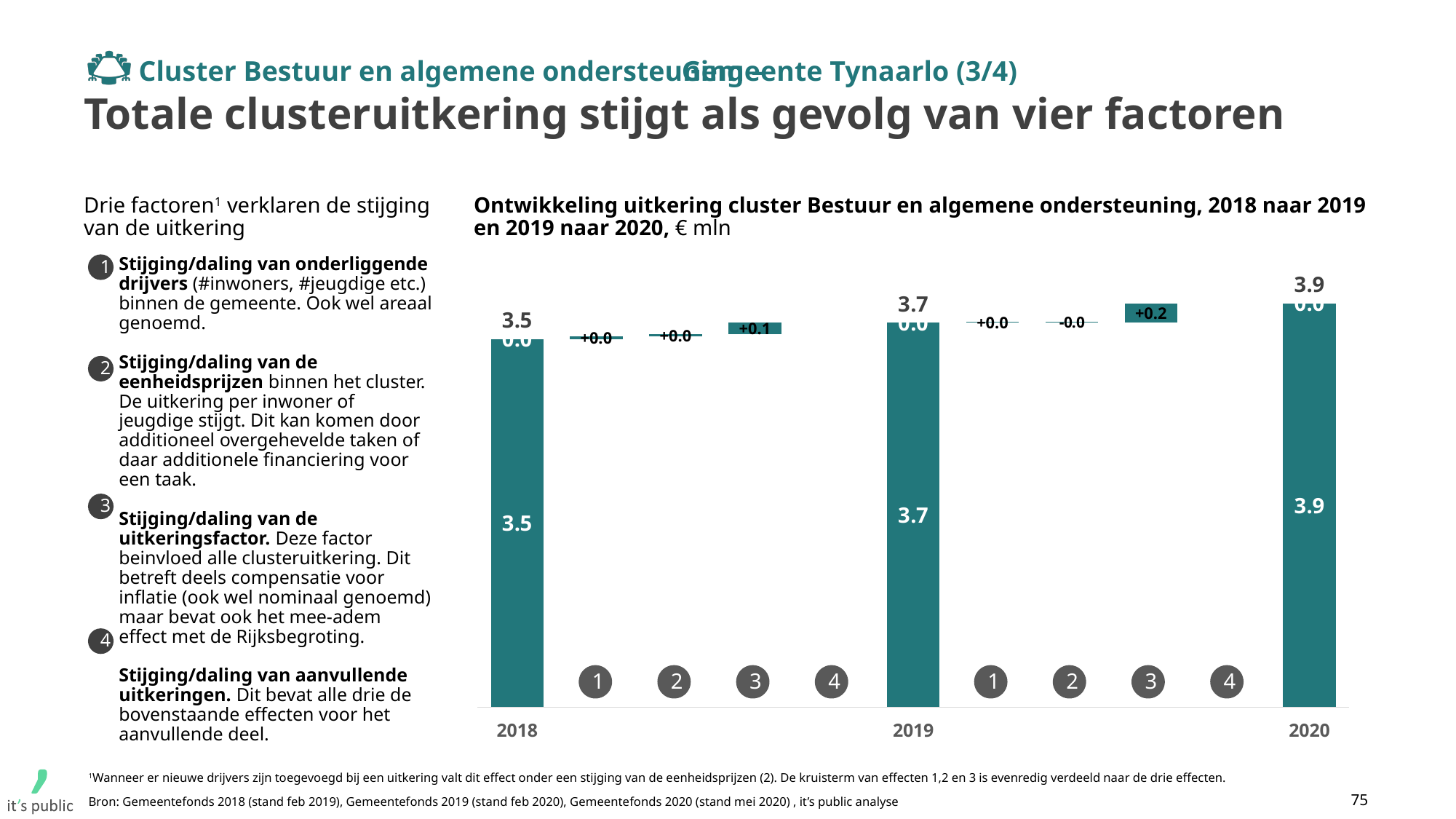
What is the effect of factor 1 from 2018 to 2019 in the chart? +0.0 Is the total uitkering larger in 2019 or in 2018? 2019 What is the total uitkering for 2020 in the chart? 3.9 Does the total uitkering rise or fall from 2018 to 2020 in the chart? rise Which year has the lowest total uitkering in the chart? 2018 What is the effect of factor 3 (uitkeringsfactor) from 2019 to 2020 in the chart? +0.2 In what unit are the values in the chart expressed? € mln What is the difference between the total uitkering in 2020 and in 2018? 0.4 Which year has the highest total uitkering in the chart? 2020 What is the effect of factor 3 (uitkeringsfactor) from 2018 to 2019 in the chart? +0.1 What is the total uitkering for 2018 in the chart? 3.5 What is the total uitkering for 2019 in the chart? 3.7